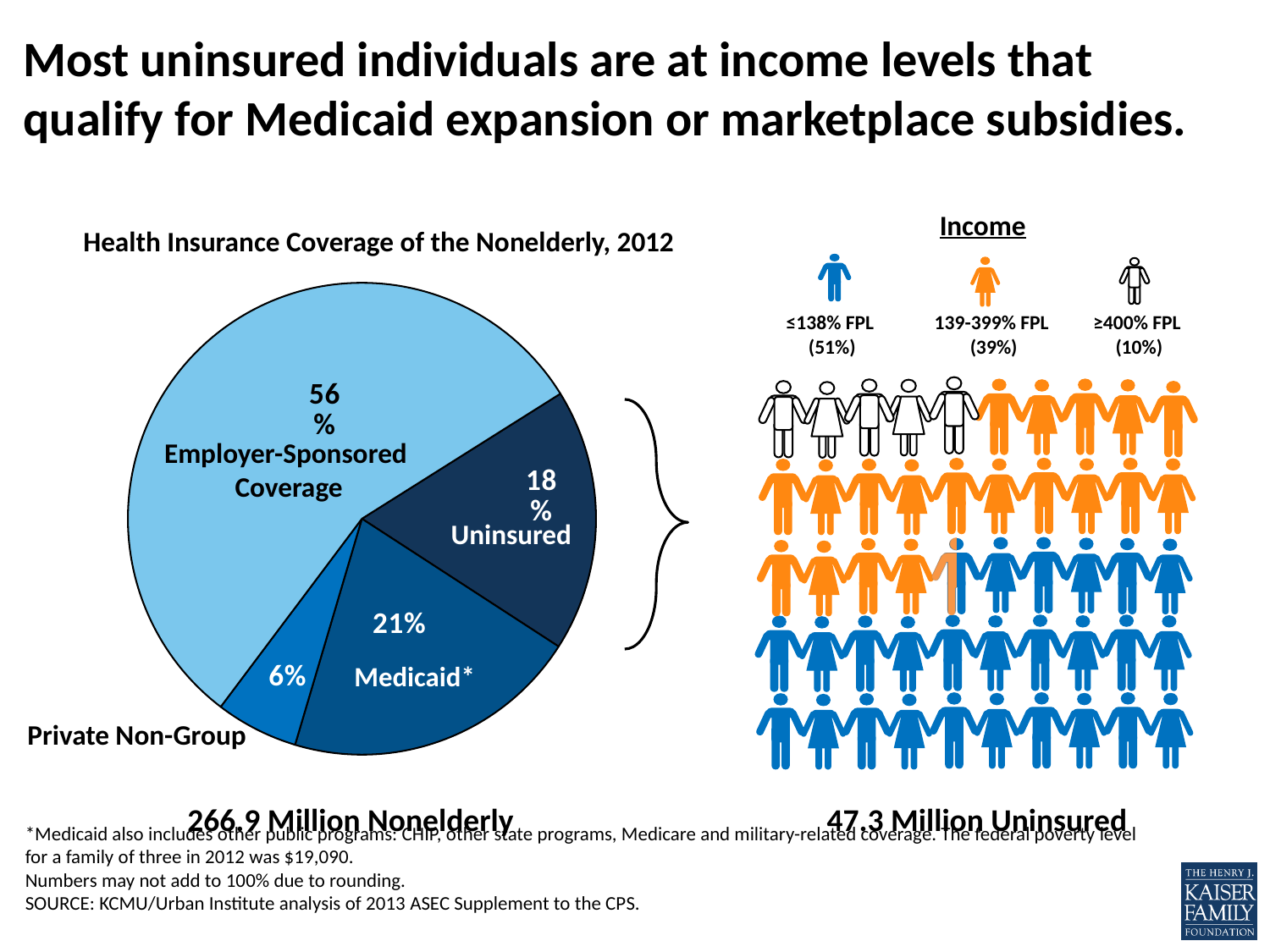
In the pie chart, what percentage of the nonelderly is Uninsured? 18% How many slices does the pie chart have? 4 In the income pictograph on the right, what percentage of the uninsured are at ≥400% FPL? 10% In the pie chart, which coverage category has the largest share? Employer-Sponsored Coverage In the pie chart, what percentage of the nonelderly is covered by Medicaid*? 21% In the pie chart, which is larger: the Medicaid* slice or the Uninsured slice? Medicaid* In the pie chart, which coverage category has the smallest share? Private Non-Group What type of chart is used to show Health Insurance Coverage of the Nonelderly, 2012? Pie chart In the pie chart, how many percentage points larger is the Medicaid* slice than the Uninsured slice? 3 In the income pictograph on the right, what percentage of the uninsured are at ≤138% FPL? 51% In the pie chart, what share of the nonelderly has Employer-Sponsored Coverage? 56% In the pie chart, what percentage of the nonelderly has Private Non-Group coverage? 6%